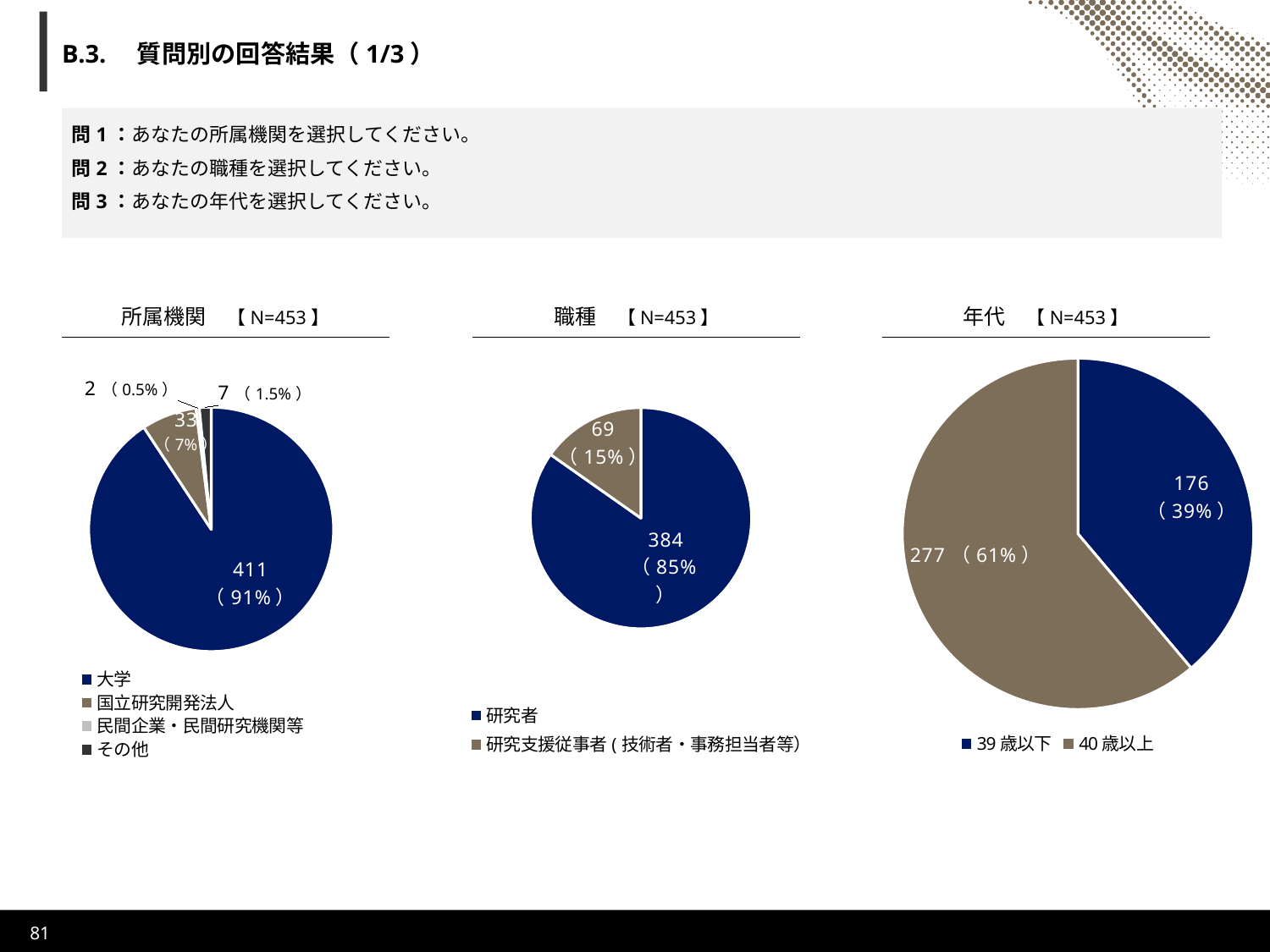
How many categories does the legend of the 所属機関 pie chart list? 4 In the 所属機関 pie chart, which category has the largest slice? 大学 What kind of chart is the 年代 chart? Pie chart In the 職種 pie chart, what share of the pie does 研究支援従事者 (技術者・事務担当者等) represent? 15% In the 職種 pie chart, what is the difference between the values for 研究者 and 研究支援従事者 (技術者・事務担当者等)? 315 What is the N value shown in the title of the 職種 chart? N=453 In the 年代 pie chart, what is the value for 40歳以上? 277 In the 職種 pie chart, what is the value for 研究者? 384 In the 年代 pie chart, which is larger, 39歳以下 or 40歳以上? 40歳以上 In the 所属機関 pie chart, what is the value for 大学? 411 In the 年代 pie chart, what share of the pie does 39歳以下 represent? 39% In the 所属機関 pie chart, what share of the pie does 国立研究開発法人 represent? 7%